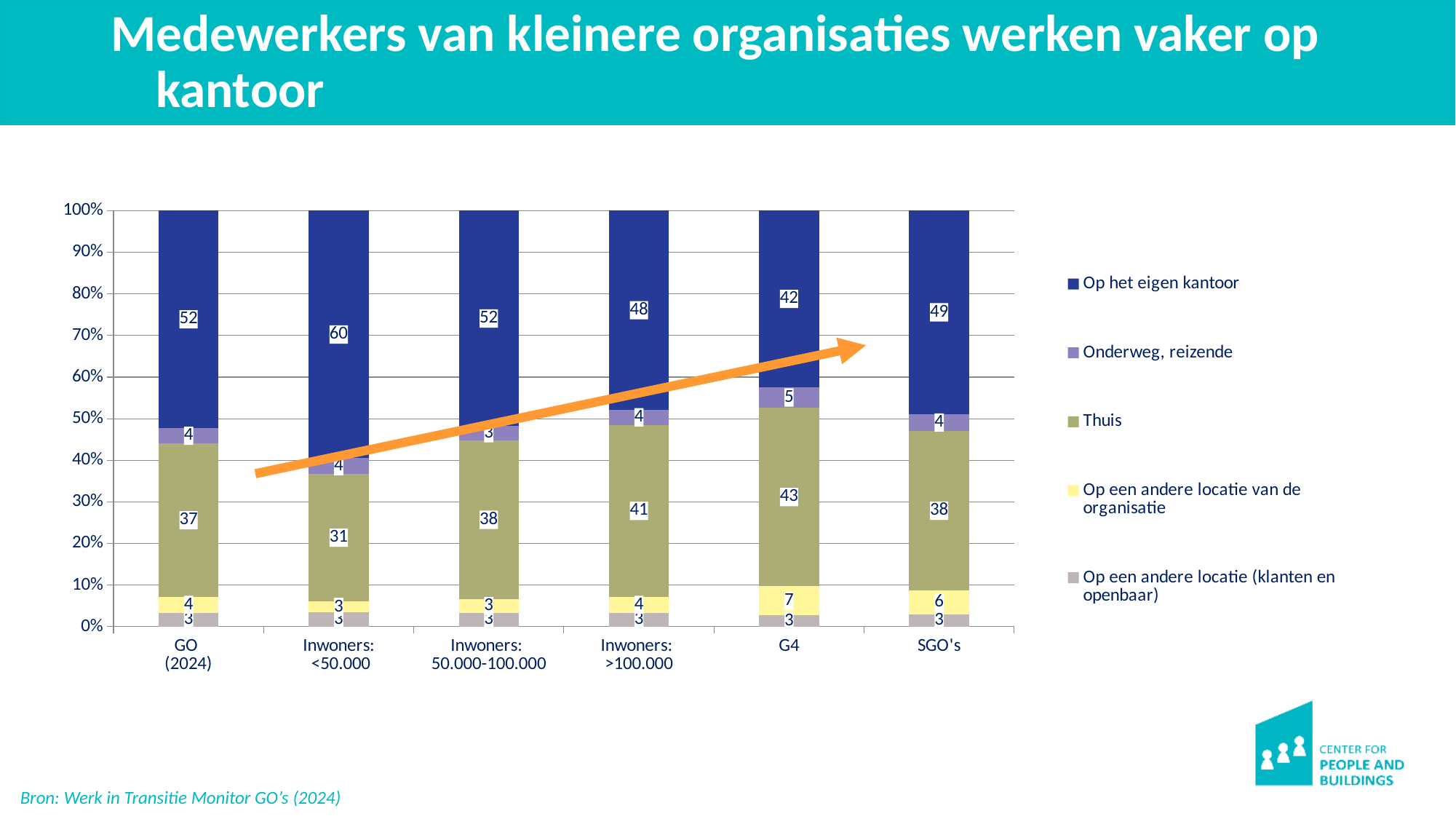
What is the value for 'Op een andere locatie van de organisatie' for the category 'G4'? 7 What is the difference between the 'Thuis' value for 'G4' and the 'Thuis' value for 'Inwoners: <50.000'? 12 Which has the larger 'Thuis' value: 'Inwoners: >100.000' or 'SGO's'? Inwoners: >100.000 Which category has the highest value for 'Op het eigen kantoor'? Inwoners: <50.000 Which category has the lowest value for 'Op het eigen kantoor'? G4 What is the value for 'Thuis' for the category 'G4'? 43 Which category has the highest value for 'Thuis'? G4 What kind of chart is shown on the slide? Stacked bar chart How many series does the legend list? 5 What is the value for 'Onderweg, reizende' for the category 'G4'? 5 How many categories are shown on the x axis of the chart? 6 What is the value for 'Op het eigen kantoor' for the category 'Inwoners: <50.000'? 60